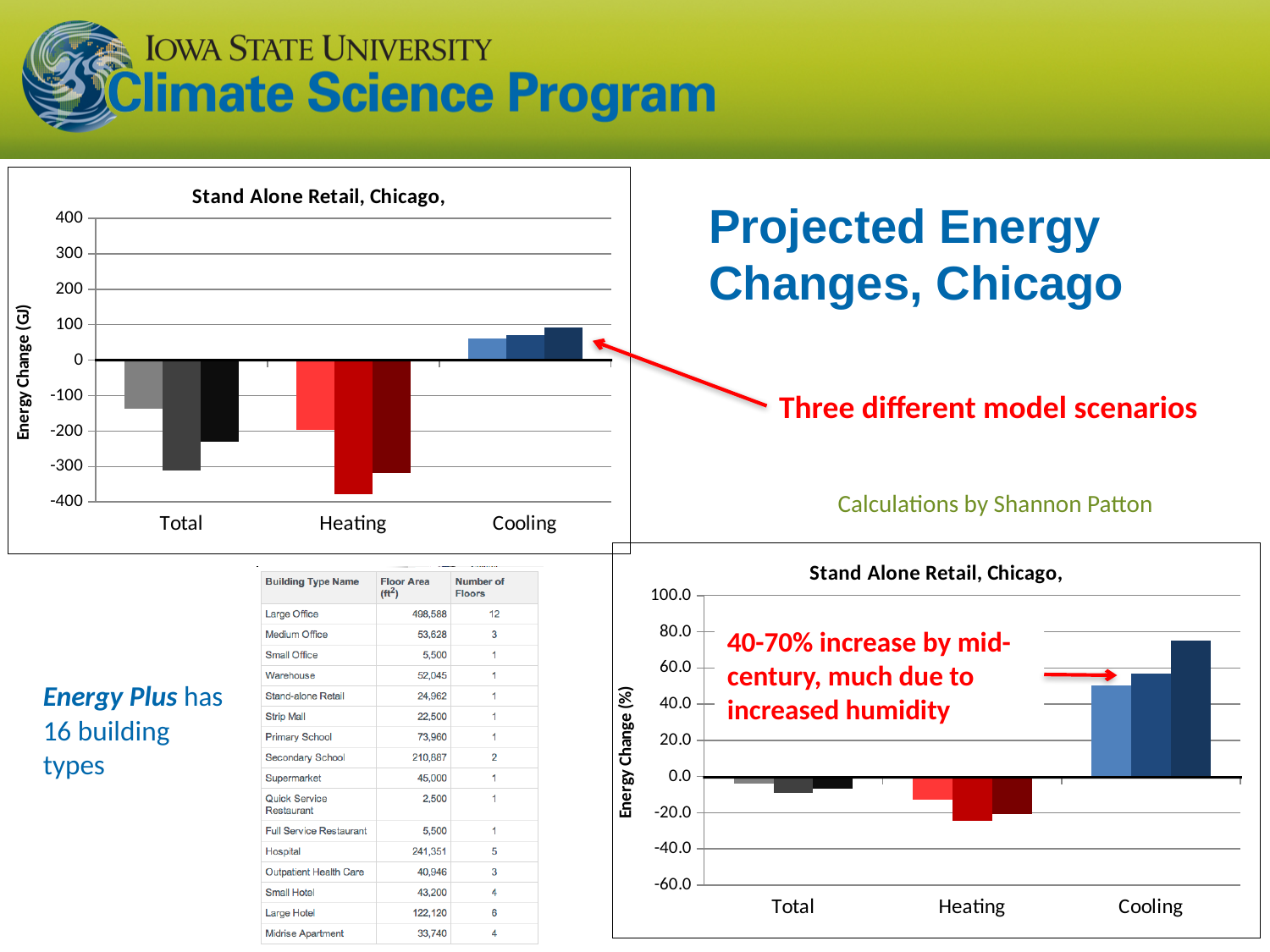
What kind of chart is the top-left chart on the slide? bar chart What kind of chart is the bottom-right chart on the slide? bar chart How many categories are shown on the x axis of the top-left chart? 3 How many categories are shown on the x axis of the bottom-right chart? 3 In the top-left chart, is the lowest Heating value greater or less than -300? less What is the y-axis label of the bottom-right chart? Energy Change (%) In the bottom-right chart, is the largest Cooling value greater or less than 60.0? greater In the top-left chart, which category contains the lowest (most negative) bar? Heating In the top-left chart, which category has the only positive values? Cooling In the bottom-right chart, which category has the highest values? Cooling In the bottom-right chart, which category contains the lowest (most negative) bar? Heating